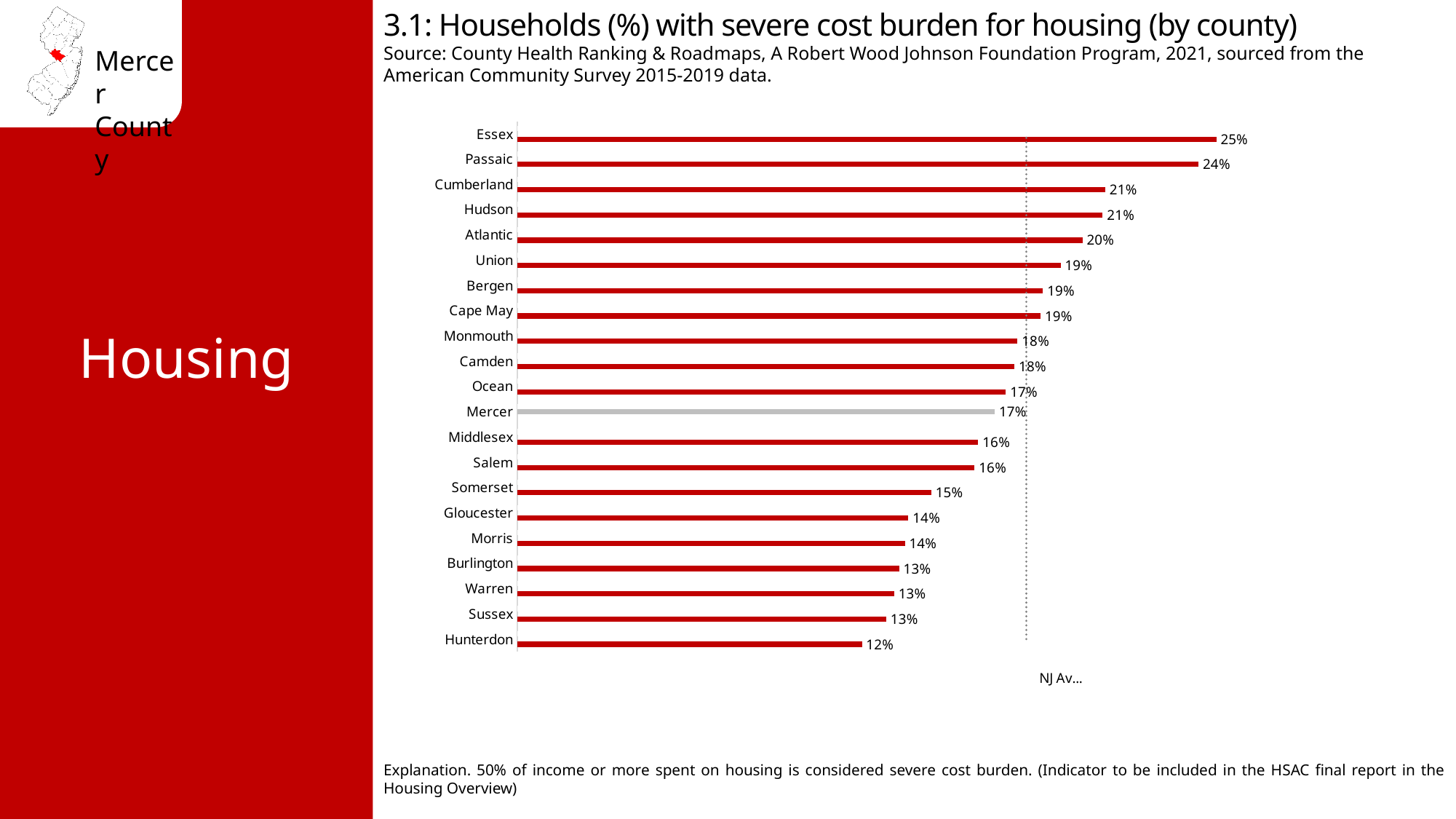
What percentage of households in Mercer County have a severe cost burden for housing? 17% What kind of chart is shown on the slide? Bar chart What is the difference in percentage points between Essex and Hunterdon? 13 percentage points What is the value shown for Essex County? 25% Which county has the lowest percentage of households with severe housing cost burden? Hunterdon What is the difference in percentage points between Mercer and Hunterdon? 5 percentage points Which county's bar is drawn in grey instead of red? Mercer What is the value shown for Hunterdon County? 12% What is the value shown for Atlantic County? 20% How many counties are shown in the chart? 21 Which has a higher value, Passaic or Atlantic? Passaic Which county has the highest percentage of households with severe housing cost burden? Essex